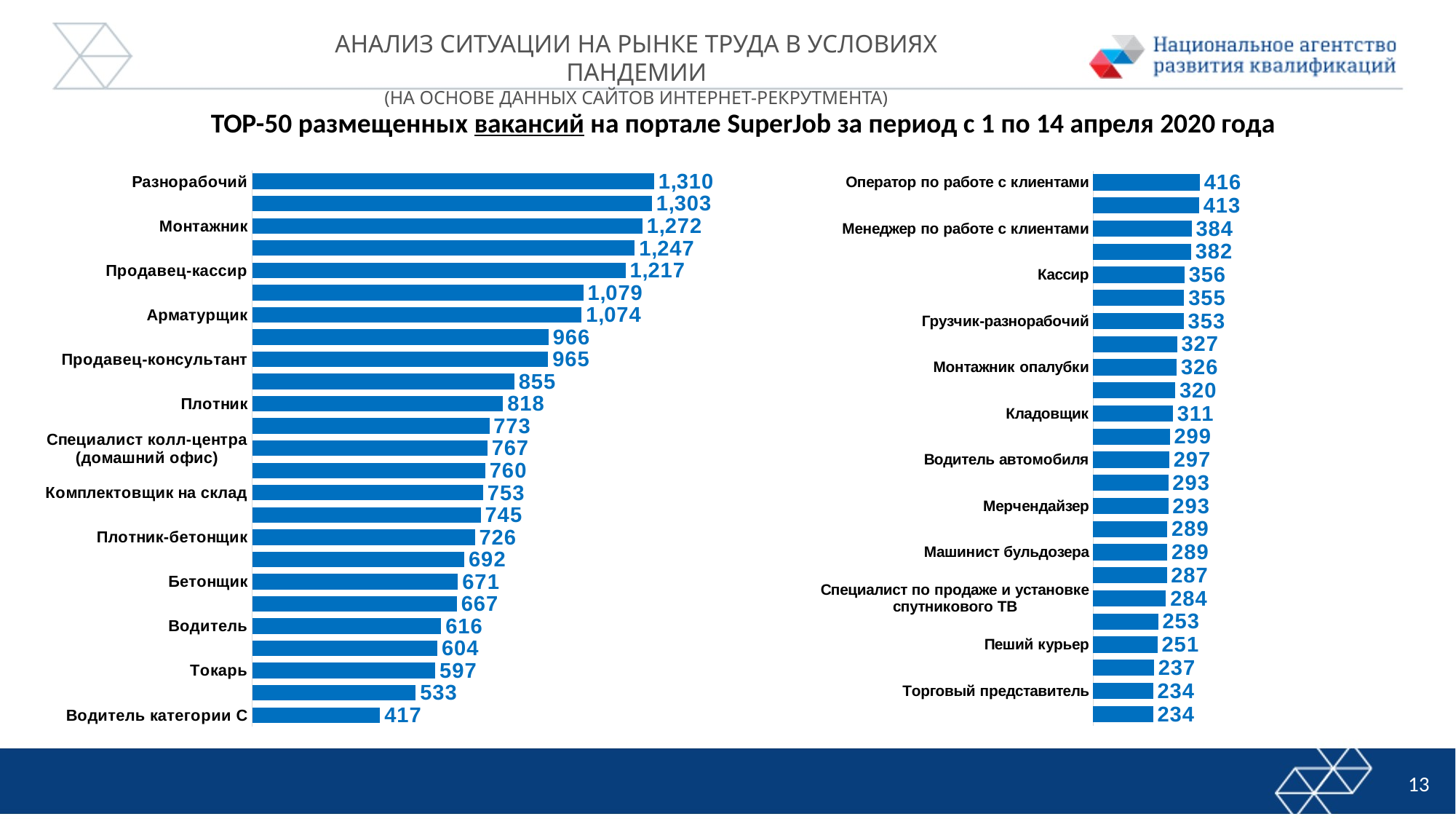
What type of chart is used on this slide? Bar chart In the right chart, which is larger: the value for Кассир or the value for Мерчендайзер? Кассир In the left chart, what is the value for Плотник-бетонщик? 726 In the right chart, what is the value for Кладовщик? 311 In the left chart, what is the value for Продавец-кассир? 1,217 In the left chart, what is the difference between the values for Монтажник and Арматурщик? 198 In the left chart, which labeled category has the highest value? Разнорабочий In the right chart, what is the value for Оператор по работе с клиентами? 416 In the left chart, how many vacancies are shown for Разнорабочий? 1,310 Which portal's vacancies are analysed in the charts, according to the title? SuperJob In the left chart, which labeled category has the lowest value? Водитель категории С In the right chart, what is the value for Пеший курьер? 251